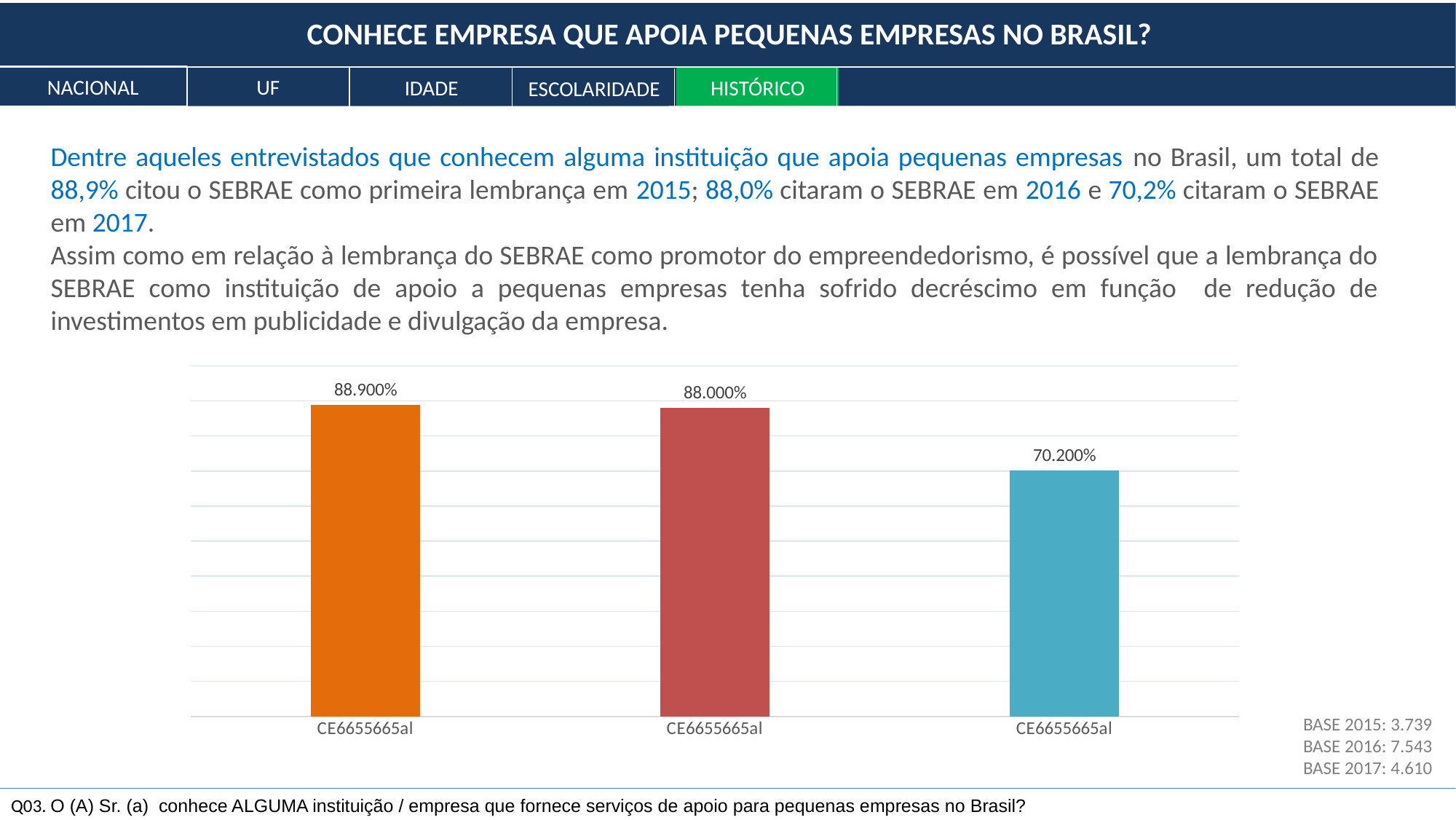
How many bars are plotted in the chart? 3 What colour is the leftmost bar? Orange Do the bar values rise or fall from left to right? Fall What value is shown on the data label of the rightmost (blue) bar? 70.200% What type of chart is shown on the slide? Bar chart Which is larger, the value of the middle bar or the value of the rightmost bar? The middle bar Which bar has the highest value? The leftmost (orange) bar What is the difference between the leftmost bar's value and the middle bar's value? 0.900% What value is shown on the data label of the leftmost (orange) bar? 88.900% What is the difference between the leftmost bar's value and the rightmost bar's value? 18.700% Which bar has the lowest value? The rightmost (blue) bar What value is shown on the data label of the middle (red) bar? 88.000%